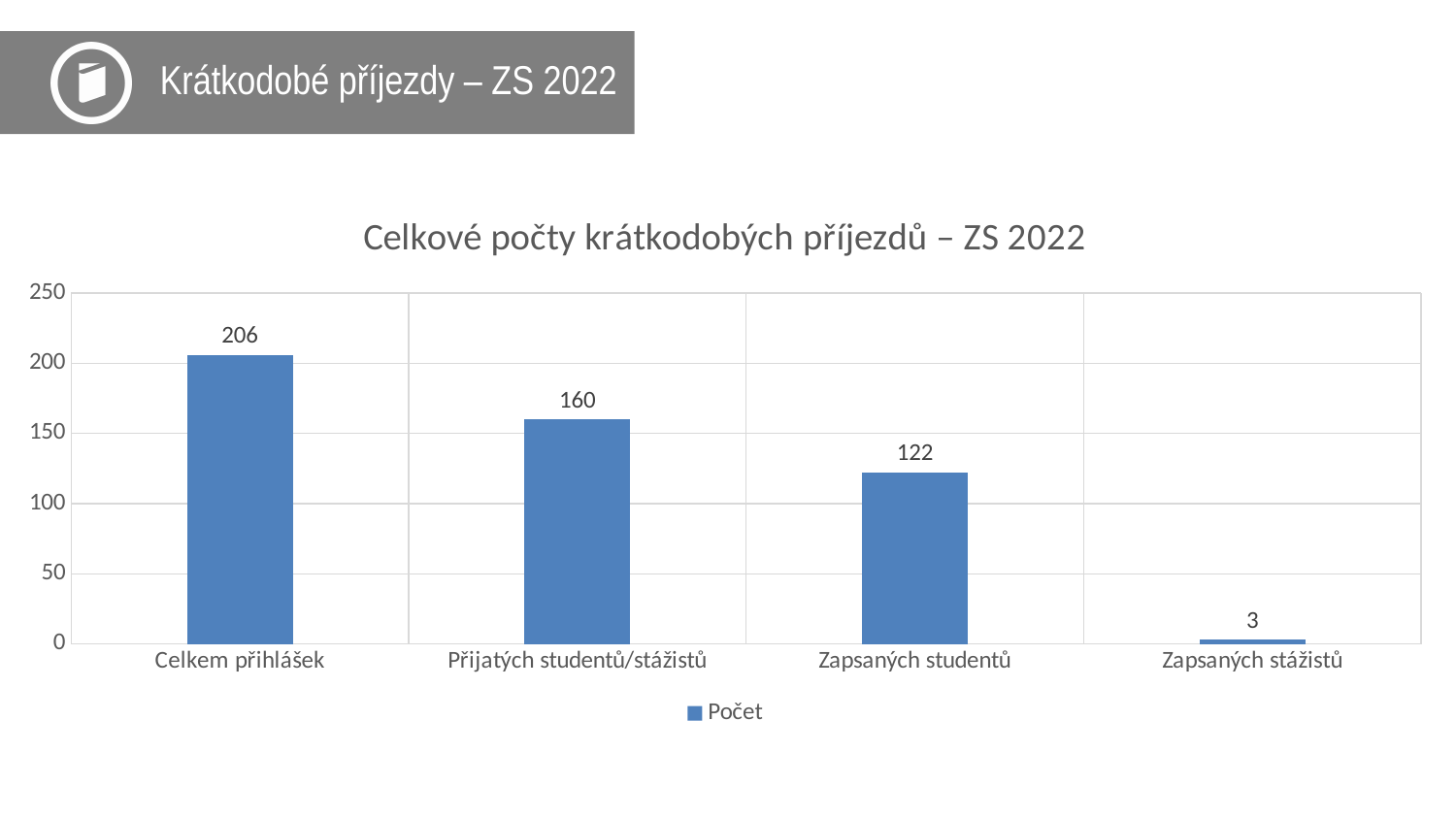
What kind of chart is this? bar chart What is the difference between Zapsaných studentů and Zapsaných stážistů? 119 What is the value for Celkem přihlášek? 206 Which category has the lowest value? Zapsaných stážistů Which category has the highest value? Celkem přihlášek What is the value for Zapsaných stážistů? 3 What is the difference between Celkem přihlášek and Přijatých studentů/stážistů? 46 Which is larger, Přijatých studentů/stážistů or Zapsaných studentů? Přijatých studentů/stážistů What is the value for Zapsaných studentů? 122 What is the value for Přijatých studentů/stážistů? 160 How many categories are shown on the x axis? 4 What is the title of the chart? Celkové počty krátkodobých příjezdů – ZS 2022